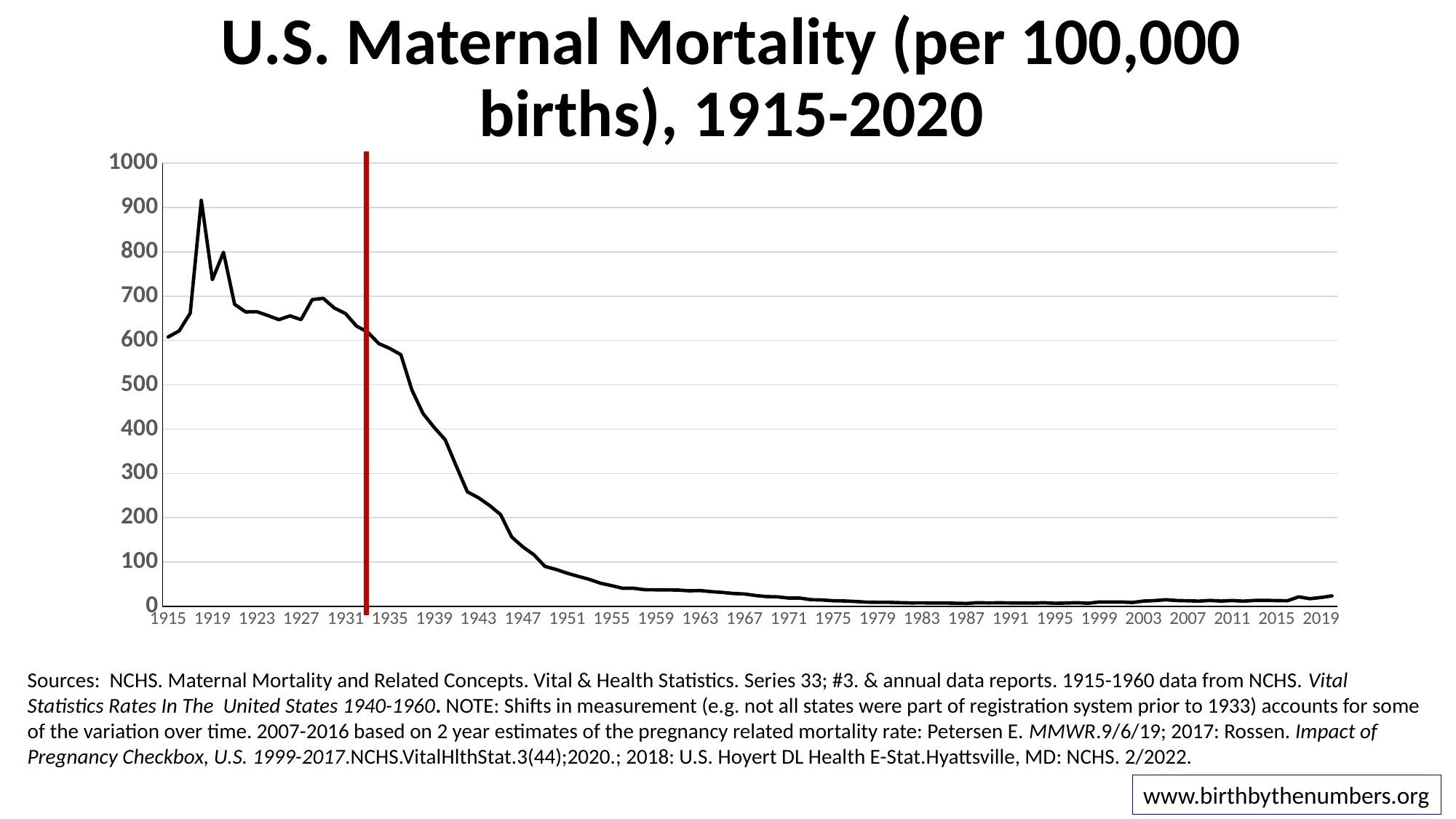
Overall, does the maternal mortality rate rise or fall from 1915 to 2019? fall Is the value for 1955 greater or less than 100? less Is the value for 2019 greater or less than 100? less What is the title of the chart? U.S. Maternal Mortality (per 100,000 births), 1915-2020 Is the value for 1927 greater or less than 500? greater Which year has the larger value, 1915 or 2019? 1915 Does the highest point of the line occur before or after the red vertical line? before What is the highest value shown on the y axis? 1000 What kind of chart is shown on the slide? line chart